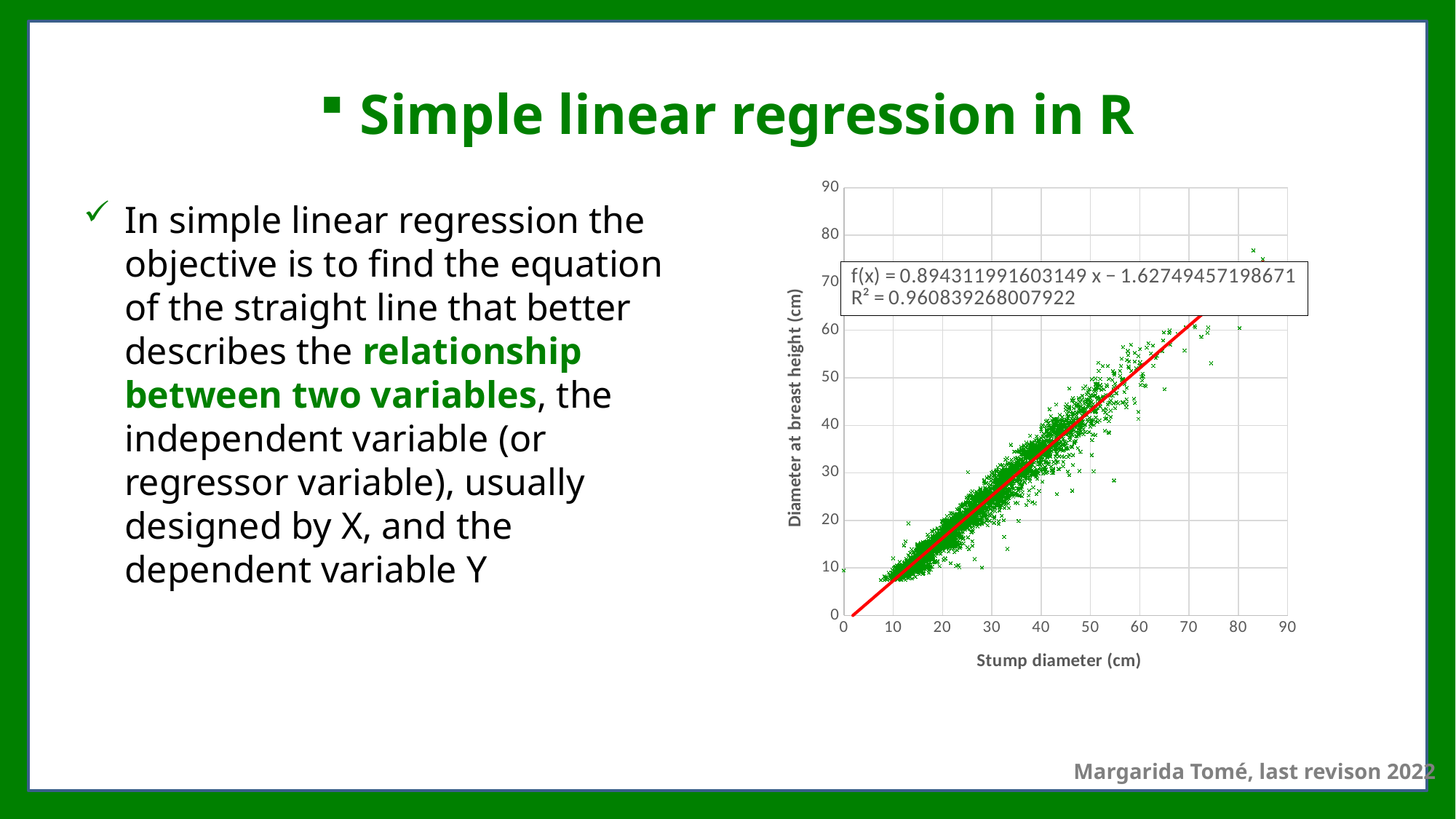
Are the points plotted at a stump diameter of about 10 cm greater or less than 20 cm in diameter at breast height? less What is the label of the y axis of the chart? Diameter at breast height (cm) What is the intercept of the fitted line f(x) printed on the chart? −1.62749457198671 Do the plotted values of diameter at breast height rise or fall as stump diameter increases along the x axis? rise What kind of chart is shown on the slide? scatter chart What is the full equation of the fitted line printed on the chart? f(x) = 0.894311991603149 x − 1.62749457198671 Are the points plotted at a stump diameter of about 85 cm greater or less than 70 cm in diameter at breast height? greater What is the label of the x axis of the chart? Stump diameter (cm) What R² value is printed on the chart for the fitted line? 0.960839268007922 What is the slope of the fitted line f(x) printed on the chart? 0.894311991603149